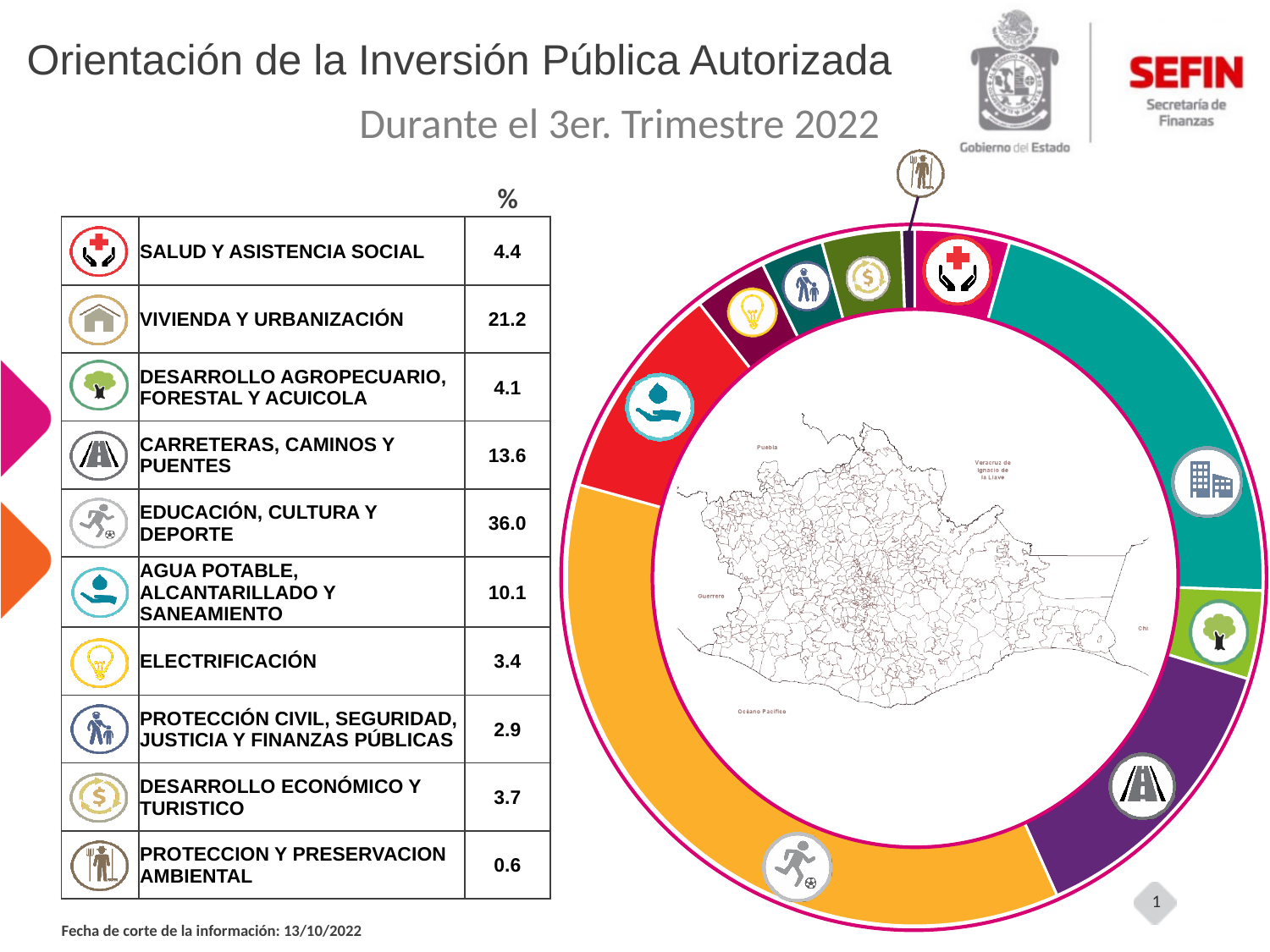
Which category has the largest share of the authorized public investment? EDUCACIÓN, CULTURA Y DEPORTE What percentage is shown for AGUA POTABLE, ALCANTARILLADO Y SANEAMIENTO? 10.1 Which is larger, the share for CARRETERAS, CAMINOS Y PUENTES or for AGUA POTABLE, ALCANTARILLADO Y SANEAMIENTO? CARRETERAS, CAMINOS Y PUENTES What percentage is shown for VIVIENDA Y URBANIZACIÓN? 21.2 What kind of chart is shown on the slide? Pie chart (donut) What percentage is shown for EDUCACIÓN, CULTURA Y DEPORTE? 36.0 What percentage is shown for CARRETERAS, CAMINOS Y PUENTES? 13.6 What is the title of the slide containing the chart? Orientación de la Inversión Pública Autorizada Which category has the smallest share of the authorized public investment? PROTECCION Y PRESERVACION AMBIENTAL What is the difference in percentage points between EDUCACIÓN, CULTURA Y DEPORTE and VIVIENDA Y URBANIZACIÓN? 14.8 How many categories are shown in the chart? 10 What share of the pie does SALUD Y ASISTENCIA SOCIAL represent? 4.4%